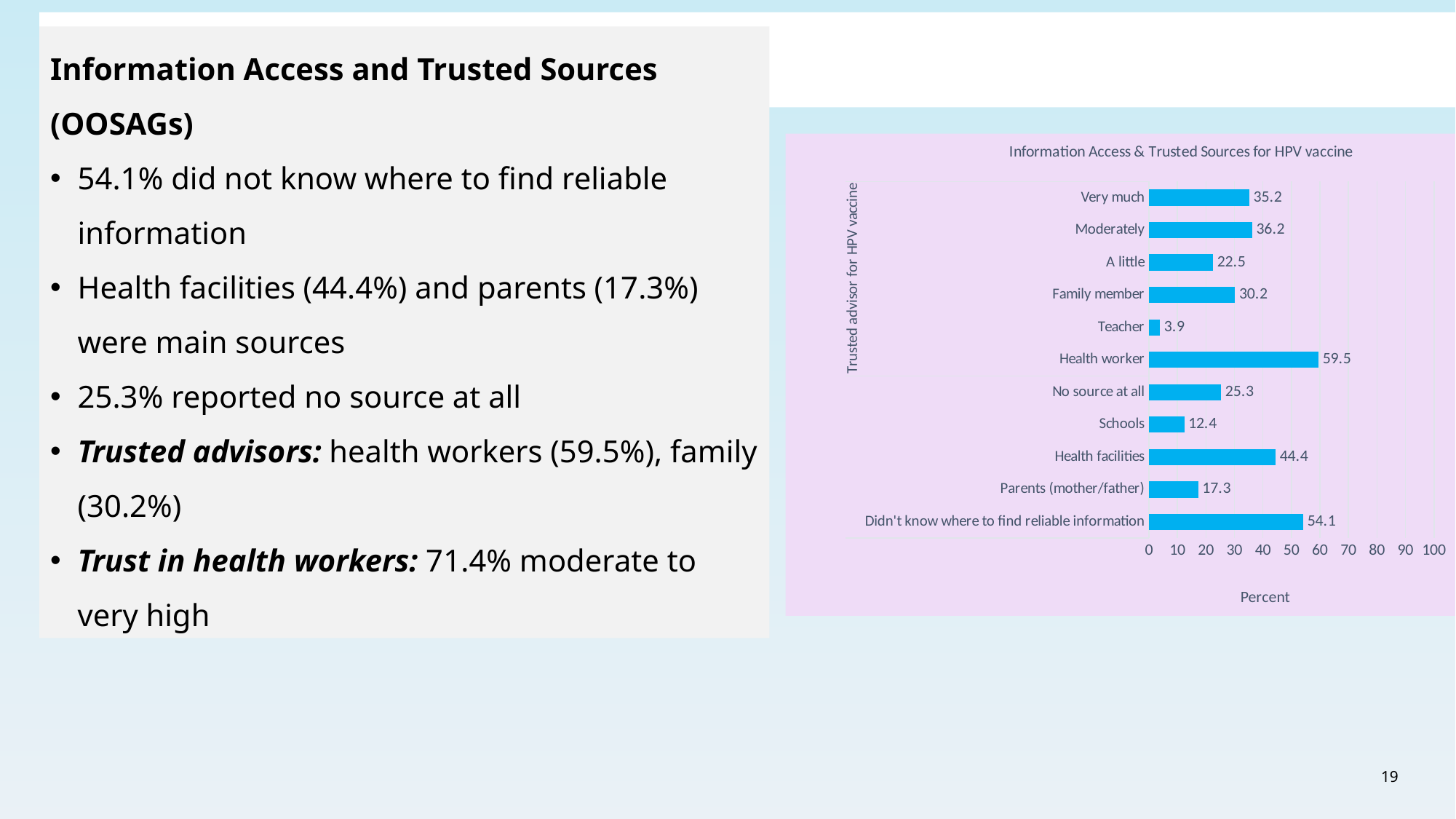
What is the value for Family member in the chart? 30.2 What is the value for Health worker in the chart? 59.5 Which is larger, the value for Very much or the value for Moderately? Moderately What is the value for Schools in the chart? 12.4 What is the value for Teacher in the chart? 3.9 Is the value for Didn't know where to find reliable information greater or less than 50? greater Which category has the highest value in the chart? Health worker What is the title of the chart? Information Access & Trusted Sources for HPV vaccine What kind of chart is shown on the slide? bar chart Which category has the lowest value in the chart? Teacher How many categories are shown in the chart? 11 What is the difference between the values for Health facilities and Parents (mother/father)? 27.1